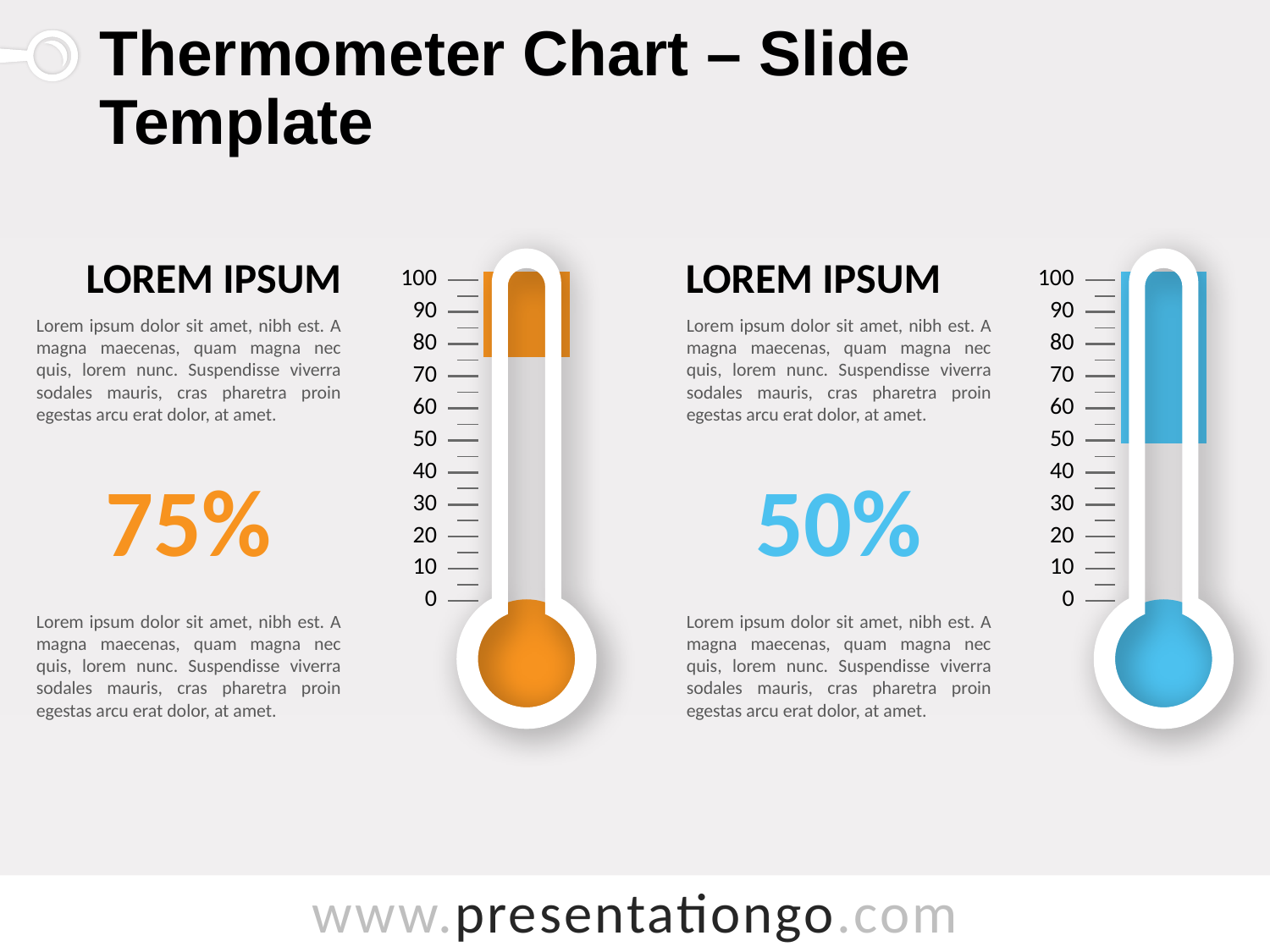
What is the lowest value marked on the scale of the right thermometer chart? 0 What is the difference between the percentages shown on the left and right thermometer charts? 25% Which thermometer chart shows the lowest percentage? the right (50%) What percentage is shown for the left (orange) thermometer chart? 75% What is the highest value marked on the scale of the left thermometer chart? 100 What percentage is shown for the right (blue) thermometer chart? 50% How many thermometer charts are on the slide? 2 What colour is the fill of the right thermometer chart? blue Which thermometer chart shows the higher percentage, the left or the right? the left (75%) Is the percentage shown for the left thermometer chart greater or less than 50? greater What kind of chart is used on this slide? thermometer chart